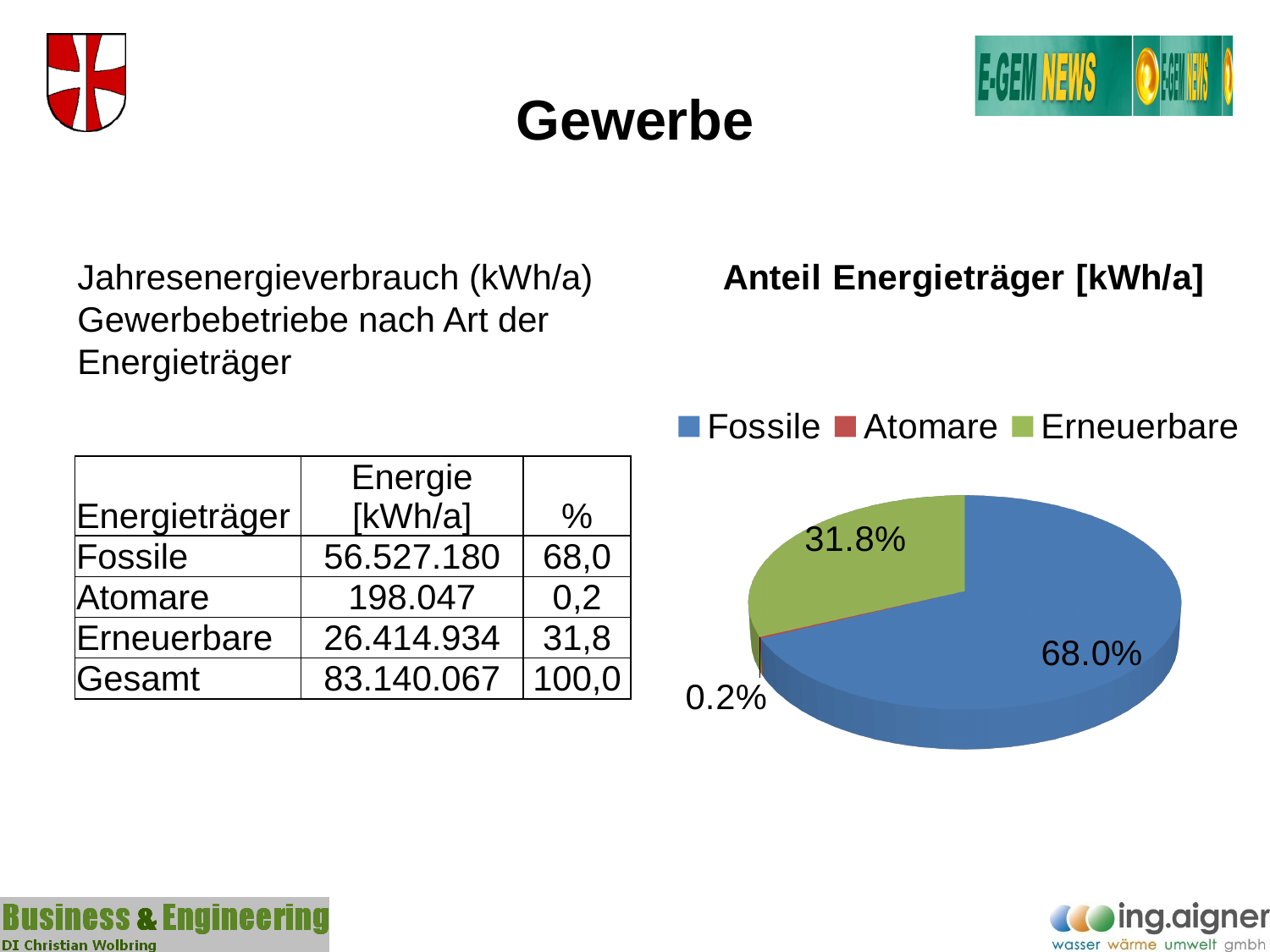
What is the title of the chart? Anteil Energieträger [kWh/a] Which is larger, the share for Erneuerbare or the share for Atomare? Erneuerbare Which category has the smallest slice of the pie? Atomare What share of the pie does Fossile have? 68.0% What is the difference in percentage points between the Fossile and Erneuerbare slices? 36.2 What share of the pie does Erneuerbare have? 31.8% How many slices does the pie chart have? 3 Which category has the largest slice of the pie? Fossile Which colour represents Erneuerbare in the pie chart? green What share of the pie does Atomare have? 0.2% What type of chart is shown on the slide? pie chart How many entries does the chart legend list? 3